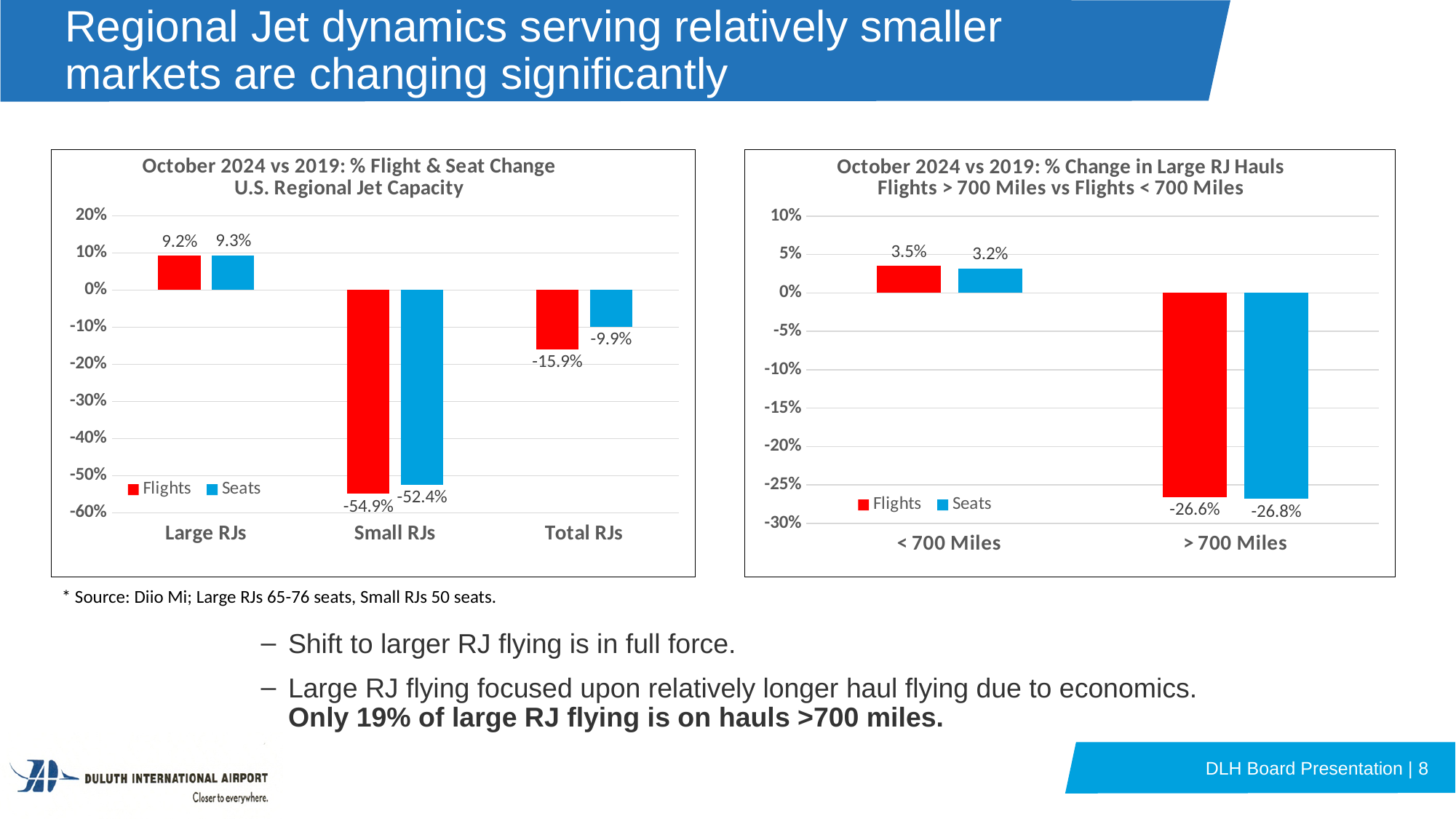
In the right chart (% Change in Large RJ Hauls), which is larger for < 700 Miles, the Flights value or the Seats value? Flights In the left chart (U.S. Regional Jet Capacity), how many categories are shown on the x axis? 3 In the left chart (U.S. Regional Jet Capacity), what is the Flights value for Small RJs? -54.9% In the right chart (% Change in Large RJ Hauls), what colour represents the Seats series? Blue In the left chart (U.S. Regional Jet Capacity), what is the Seats value for Total RJs? -9.9% In the left chart (U.S. Regional Jet Capacity), how many series does the legend list? 2 What type of chart is the right chart (% Change in Large RJ Hauls)? Bar chart In the left chart (U.S. Regional Jet Capacity), what is the difference between the Flights and Seats values for Total RJs? 6.0 percentage points In the left chart (U.S. Regional Jet Capacity), which category has the lowest Flights value? Small RJs In the right chart (% Change in Large RJ Hauls), what is the Seats value for < 700 Miles? 3.2% In the right chart (% Change in Large RJ Hauls), what is the Flights value for > 700 Miles? -26.6% In the left chart (U.S. Regional Jet Capacity), what is the Seats value for Large RJs? 9.3%